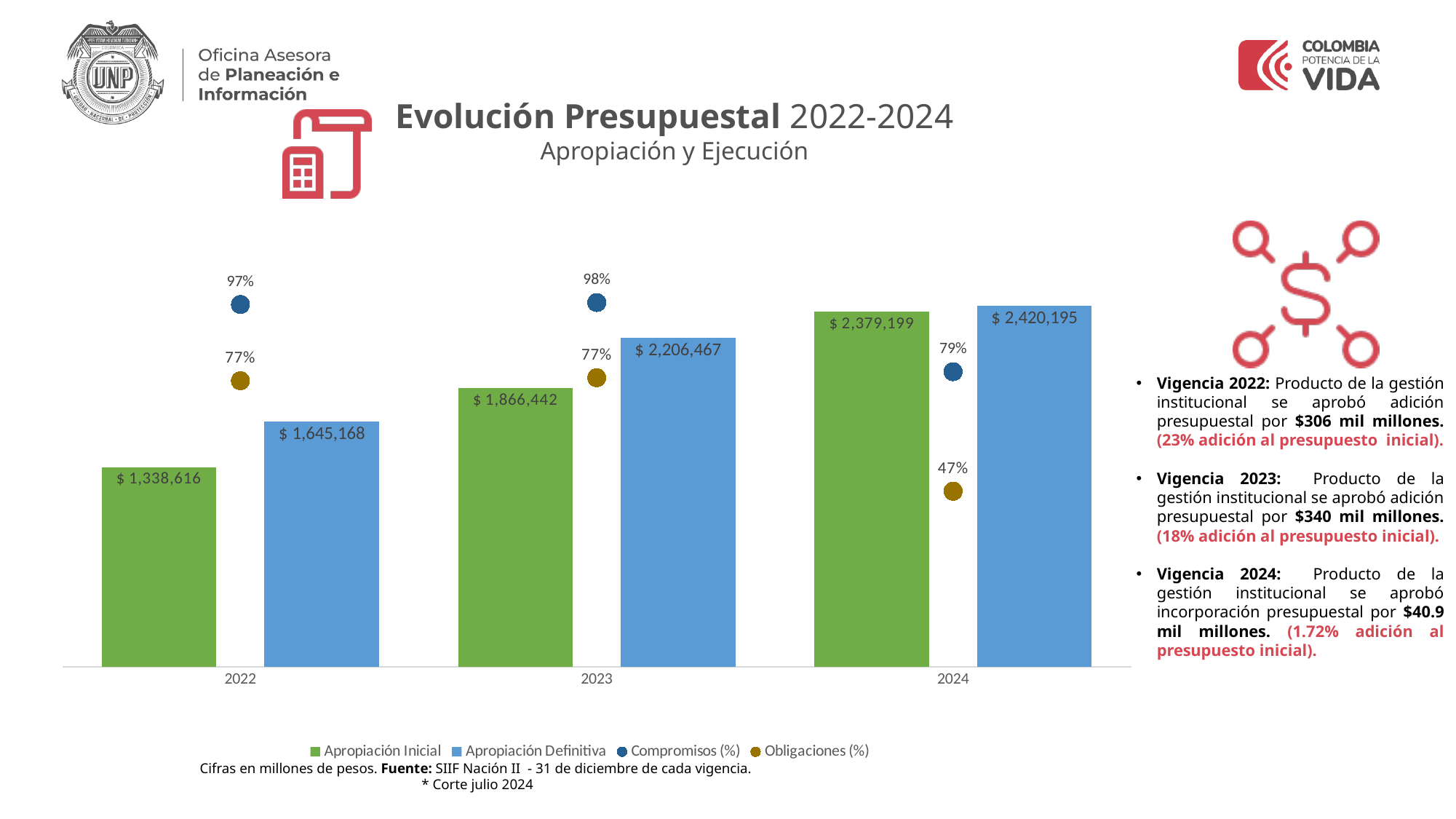
What colour are the Apropiación Definitiva bars? blue Does the Apropiación Inicial rise or fall from 2022 to 2024? rise Which year has the lowest Obligaciones (%)? 2024 What is the Apropiación Definitiva value for 2023? $ 2,206,467 How many years are shown on the x axis? 3 What is the Apropiación Inicial value for 2022? $ 1,338,616 What is the Obligaciones (%) value for 2022? 77% What is the Compromisos (%) value for 2024? 79% Which year has the highest Apropiación Definitiva? 2024 Which is larger in 2023, Compromisos (%) or Obligaciones (%)? Compromisos (%) What is the difference between Apropiación Definitiva and Apropiación Inicial in 2022? $ 306,552 How many series does the legend list? 4